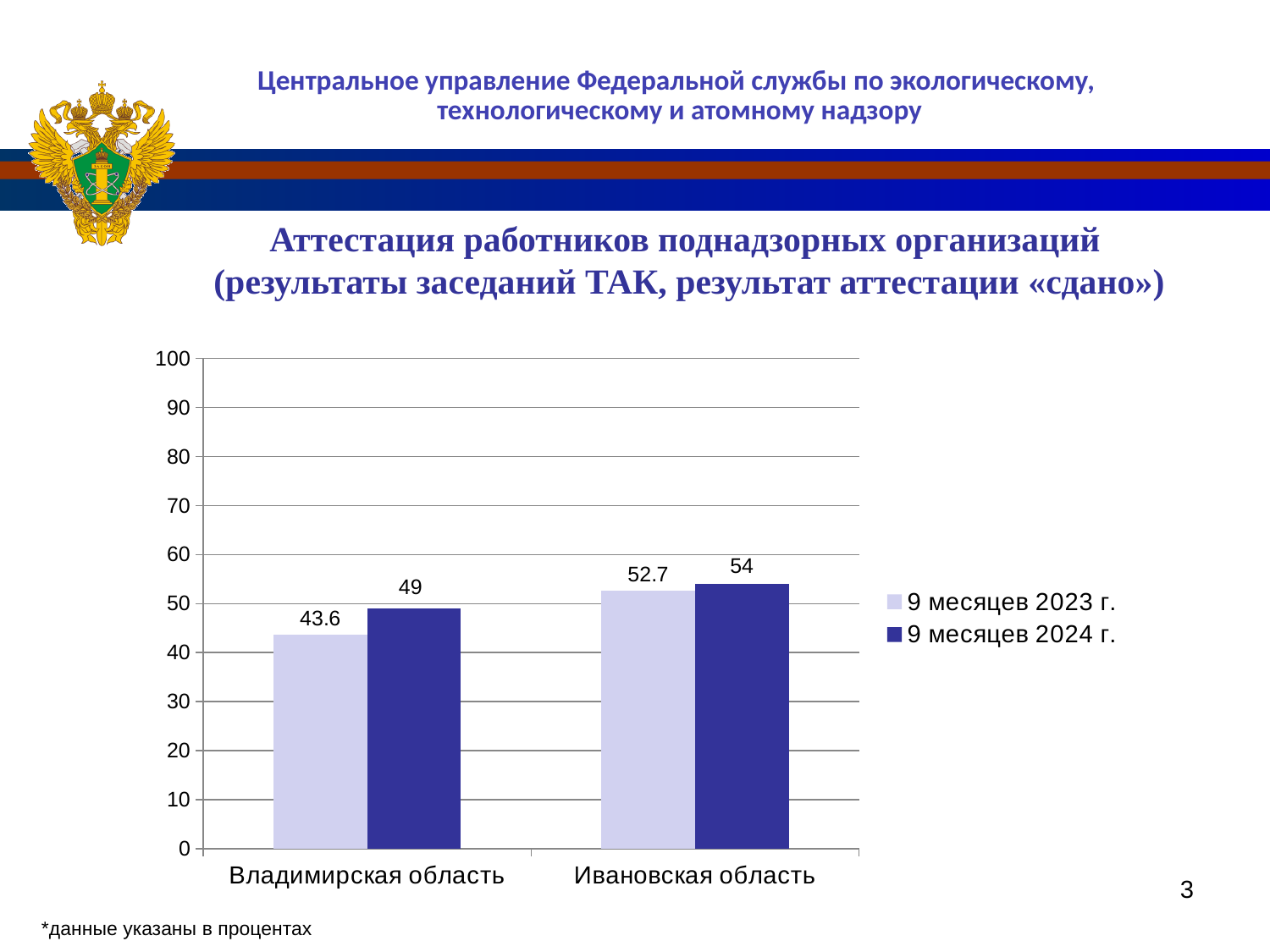
Which category has the lowest value in the 9 месяцев 2023 г. series? Владимирская область What is the value for Ивановская область in the 9 месяцев 2023 г. series? 52.7 What is the value for Владимирская область in the 9 месяцев 2024 г. series? 49 What is the value for Владимирская область in the 9 месяцев 2023 г. series? 43.6 How many categories are shown on the x axis? 2 Is the value for Владимирская область in the 9 месяцев 2023 г. series greater or less than 50? less What kind of chart is shown on the slide? bar chart What is the value for Ивановская область in the 9 месяцев 2024 г. series? 54 Which is larger for Ивановская область: the 9 месяцев 2023 г. value or the 9 месяцев 2024 г. value? 9 месяцев 2024 г. How many series does the legend list? 2 What is the difference between the 9 месяцев 2024 г. and 9 месяцев 2023 г. values for Владимирская область? 5.4 Which category has the highest value in the 9 месяцев 2024 г. series? Ивановская область